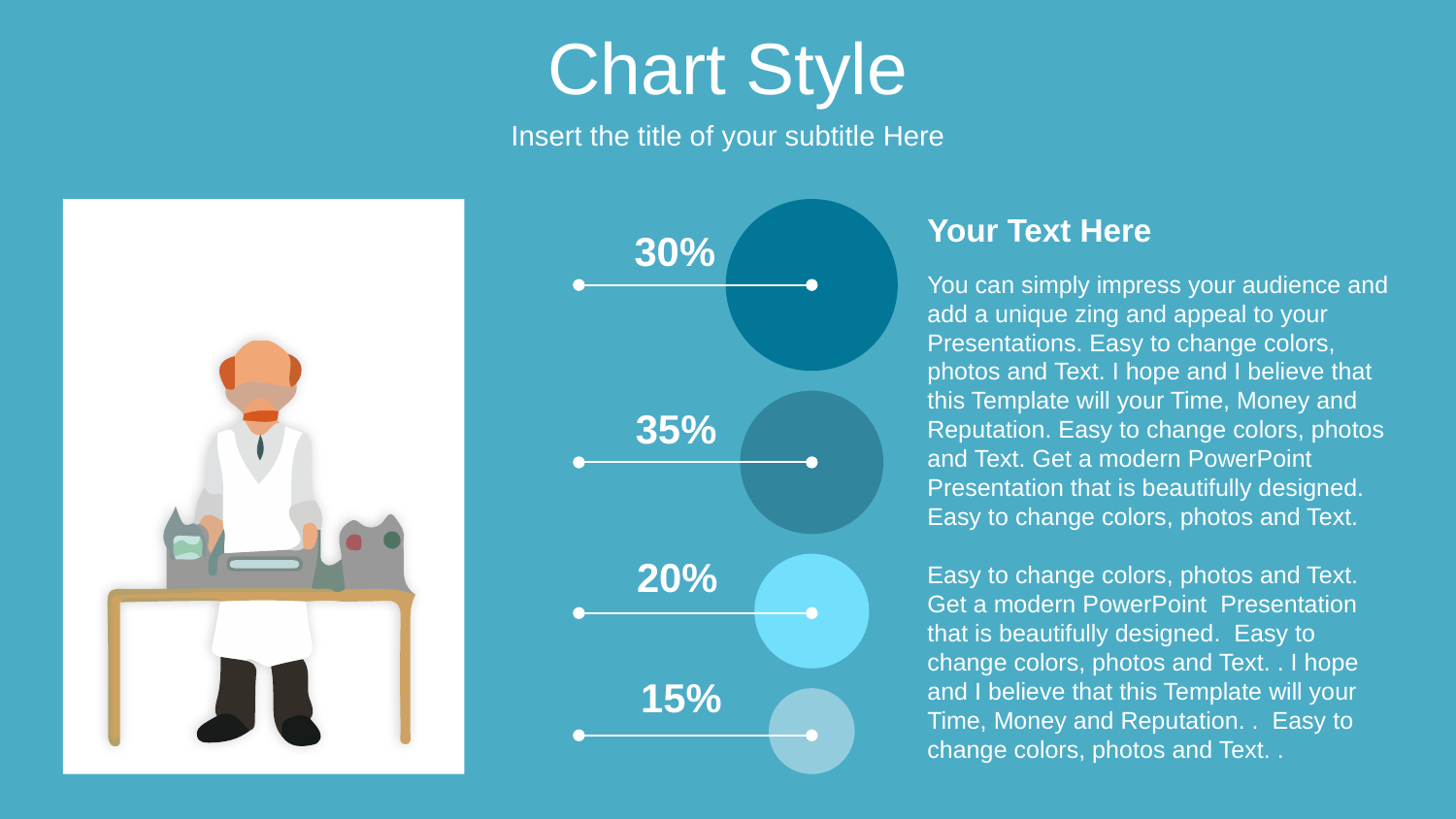
What kind of chart is shown on the slide? bubble chart Which value is the lowest among the four circles? 15% What is the title of the slide containing the chart? Chart Style How many circles (data points) does the chart show? 4 What is the value shown for the topmost circle? 30% What is the value shown for the second circle from the top? 35% What do the four percentages on the chart add up to? 100% Which value is the highest among the four circles? 35% Which is larger, the value of the top circle or the value of the bottom circle? top circle (30%) What is the value shown for the bottom circle? 15% What is the value shown for the third circle from the top? 20% What is the difference between the second circle's value and the top circle's value? 5%